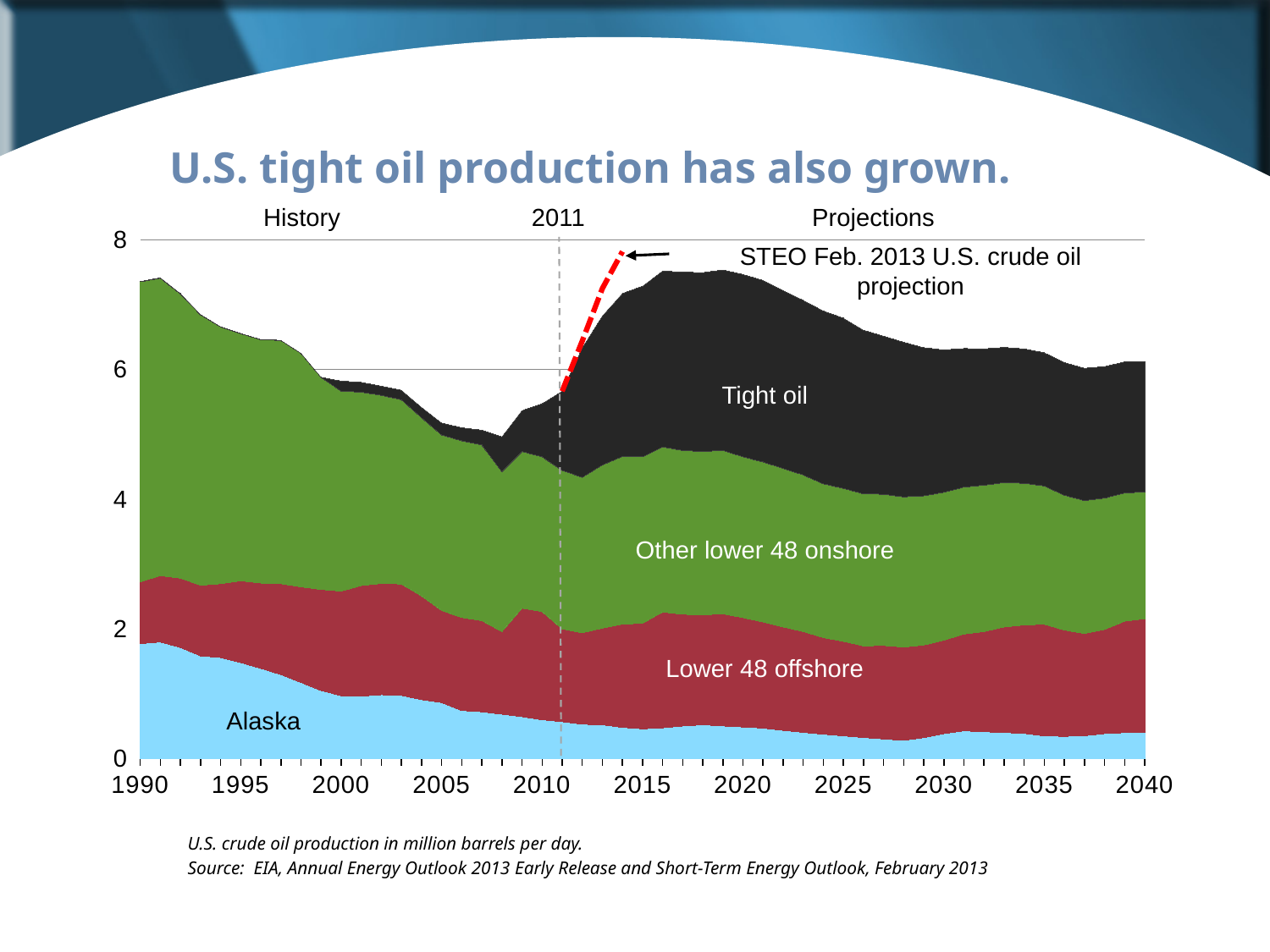
Does tight oil production rise or fall between 2011 and 2020? rise Is Alaska production in 1990 greater or less than 2 million barrels per day? less Which category is stacked at the bottom of the chart? Alaska What is the title of the slide's chart? U.S. tight oil production has also grown. What kind of chart is shown on the slide? Stacked area chart Which year does the dashed vertical line separating History from Projections mark? 2011 How many production categories are labeled as areas in the chart? 4 Is total U.S. crude oil production in 2020 greater or less than 8 million barrels per day? less Is total U.S. crude oil production in 1990 greater or less than 6 million barrels per day? greater Does Alaska production rise or fall from 1990 to 2040? fall Does total U.S. crude oil production rise or fall between 1990 and 2008? fall